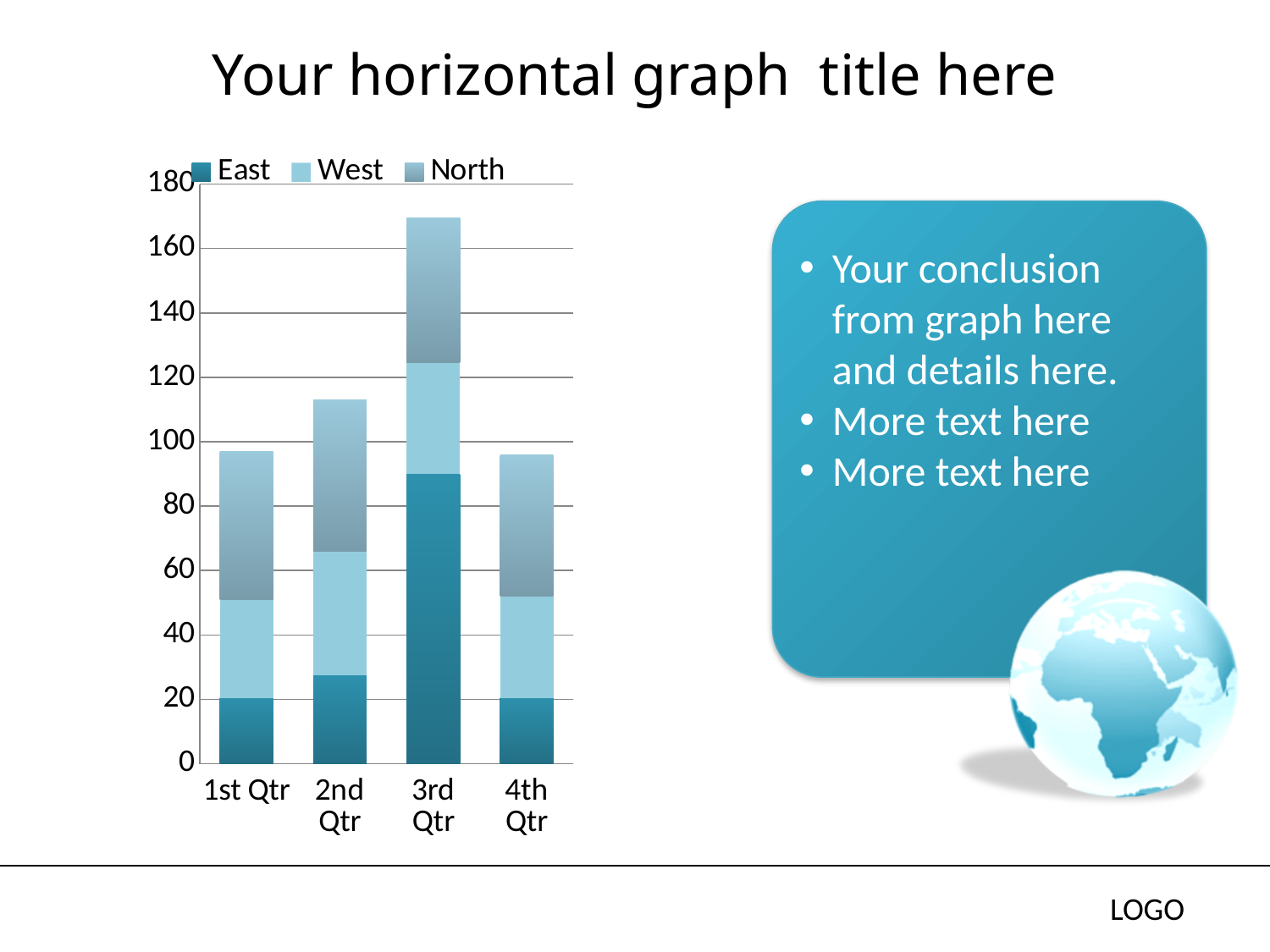
Is the total stacked value for 2nd Qtr greater or less than 100? greater Is the total stacked value for 4th Qtr greater or less than 120? less Which has the larger total stacked value, 2nd Qtr or 4th Qtr? 2nd Qtr What kind of chart is shown on the slide? stacked bar chart Which quarter has the tallest stacked bar overall? 3rd Qtr How many quarters are shown on the x axis? 4 Which quarter has the largest East value? 3rd Qtr Is the total stacked value for 3rd Qtr greater or less than 160? greater Which has the larger East value, 3rd Qtr or 2nd Qtr? 3rd Qtr What are the three series names listed in the legend? East, West, North How many series does the legend list? 3